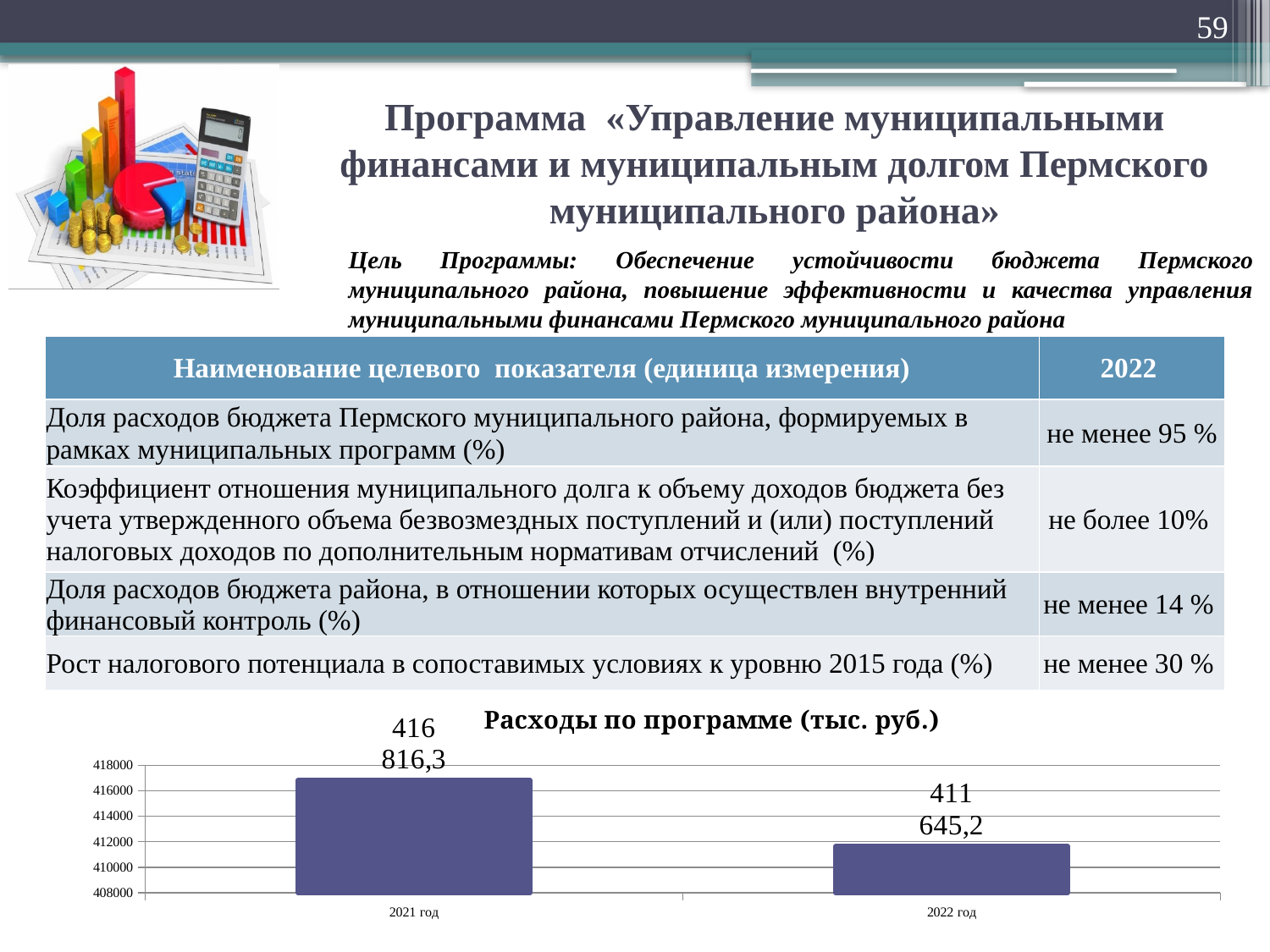
Which year has the lowest value in the chart "Расходы по программе (тыс. руб.)"? 2022 год Is the value for 2021 год in the chart "Расходы по программе (тыс. руб.)" greater or less than 414000? greater What is the value for 2022 год in the chart "Расходы по программе (тыс. руб.)"? 411 645,2 What is the title of the bar chart at the bottom of the slide? Расходы по программе (тыс. руб.) Which year has the highest value in the chart "Расходы по программе (тыс. руб.)"? 2021 год How many categories are shown on the x axis of the chart "Расходы по программе (тыс. руб.)"? 2 What is the value for 2021 год in the chart "Расходы по программе (тыс. руб.)"? 416 816,3 Is the value for 2022 год in the chart "Расходы по программе (тыс. руб.)" greater or less than 414000? less Do the values rise or fall from 2021 год to 2022 год in the chart "Расходы по программе (тыс. руб.)"? fall What type of chart is shown under the title "Расходы по программе (тыс. руб.)"? bar chart What is the difference between the values for 2021 год and 2022 год in the chart "Расходы по программе (тыс. руб.)"? 5 171,1 In the chart "Расходы по программе (тыс. руб.)", which is larger: the value for 2021 год or for 2022 год? 2021 год